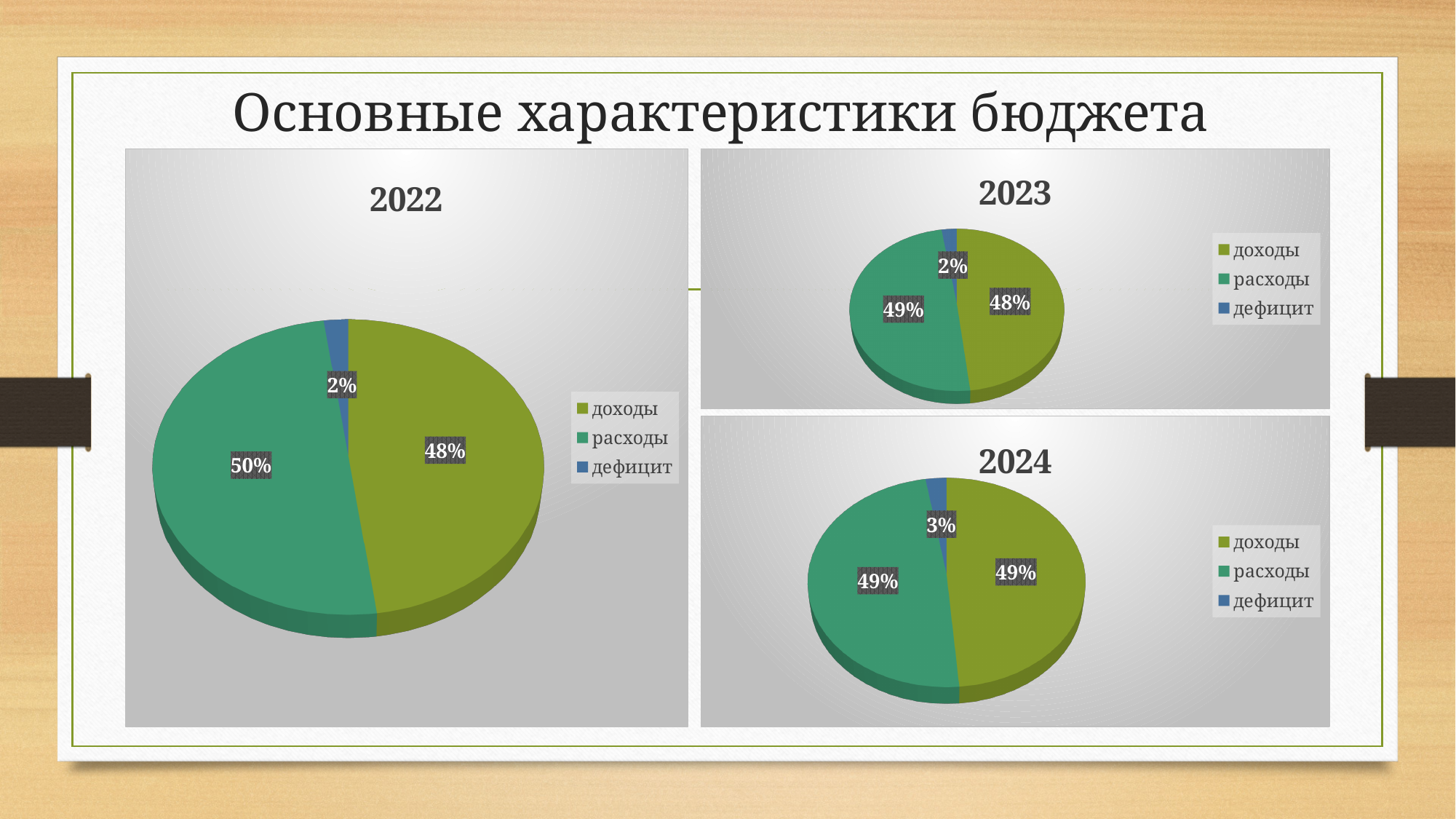
In the 2023 chart, what share is labelled for дефицит? 2% In the 2022 chart, what is the difference between the расходы and доходы shares? 2% In the 2022 chart, which category has the smallest slice? дефицит In the 2023 chart, what share is labelled for расходы? 49% In the 2022 chart, what share is labelled for расходы? 50% In the 2022 chart, which category has the largest slice? расходы In the 2024 chart, what is the difference between the доходы and дефицит shares? 46% In the 2024 chart, what share is labelled for дефицит? 3% What kind of chart is the 2023 chart? pie chart How many slices does the 2024 chart have? 3 How many entries does the legend of the 2023 chart list? 3 In the 2022 chart, what share is labelled for доходы? 48%